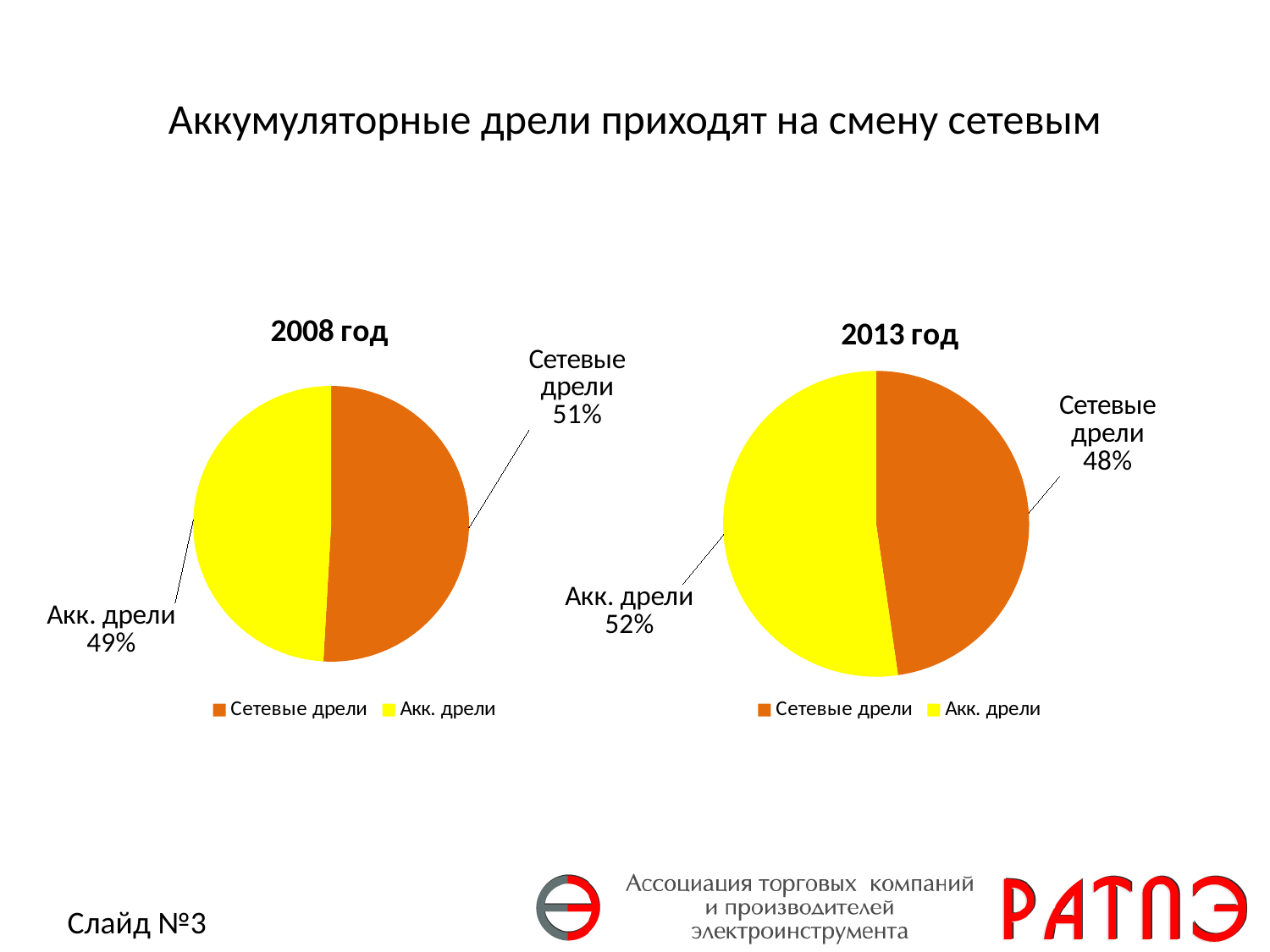
How many entries does the legend of the "2013 год" chart list? 2 How many slices does the "2008 год" pie chart have? 2 In the "2013 год" chart, what is the difference in percentage points between Акк. дрели and Сетевые дрели? 4 In the "2013 год" chart, what share do Акк. дрели have? 52% In the "2008 год" chart, what is the difference in percentage points between Сетевые дрели and Акк. дрели? 2 In the "2008 год" chart, which category has the larger slice? Сетевые дрели In the "2013 год" chart, which category has the smaller slice? Сетевые дрели In the "2008 год" chart, what share do Сетевые дрели have? 51% What type of chart is the "2013 год" chart? Pie chart In the "2008 год" chart, what colour is the Акк. дрели slice? Yellow In the "2013 год" chart, what share do Сетевые дрели have? 48%